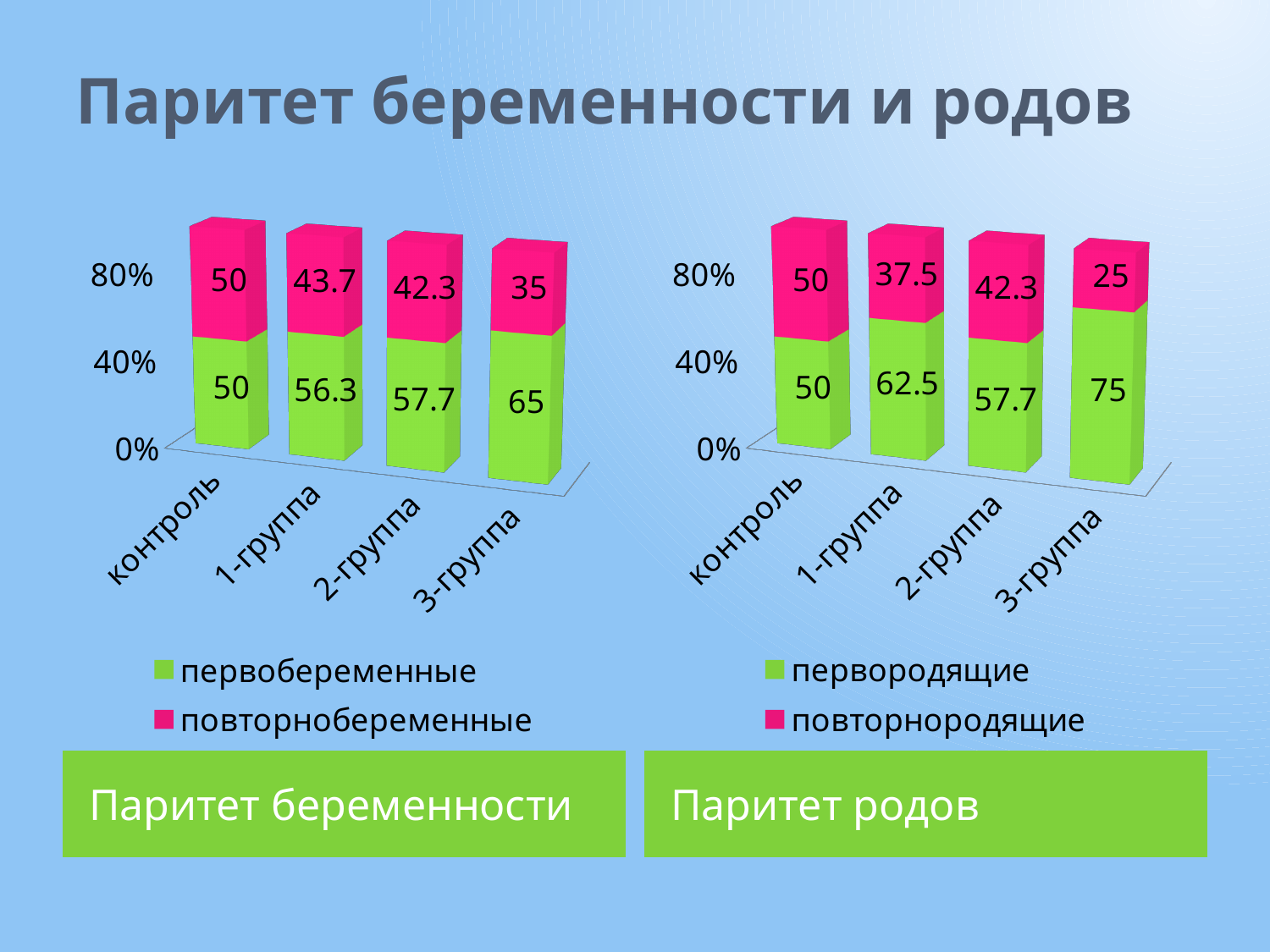
In the left chart (Паритет беременности), what is the difference between первобеременные and повторнобеременные in 2-группа? 15.4 In the left chart (Паритет беременности), what is the value for первобеременные in 3-группа? 65 In the left chart (Паритет беременности), what is the value for повторнобеременные in 1-группа? 43.7 In the right chart (Паритет родов), what is the value for повторнородящие in 3-группа? 25 In the right chart (Паритет родов), which category has the highest value for первородящие? 3-группа In the right chart (Паритет родов), what is the value for первородящие in 1-группа? 62.5 In the right chart (Паритет родов), what is the total of the stacked bar for контроль? 100 What kind of chart is the left chart (Паритет беременности)? stacked bar chart How many series does the legend of the right chart (Паритет родов) list? 2 How many categories are shown on the x axis of the left chart (Паритет беременности)? 4 In the right chart (Паритет родов), which is larger in 1-группа: первородящие or повторнородящие? первородящие In the left chart (Паритет беременности), which category has the lowest value for повторнобеременные? 3-группа